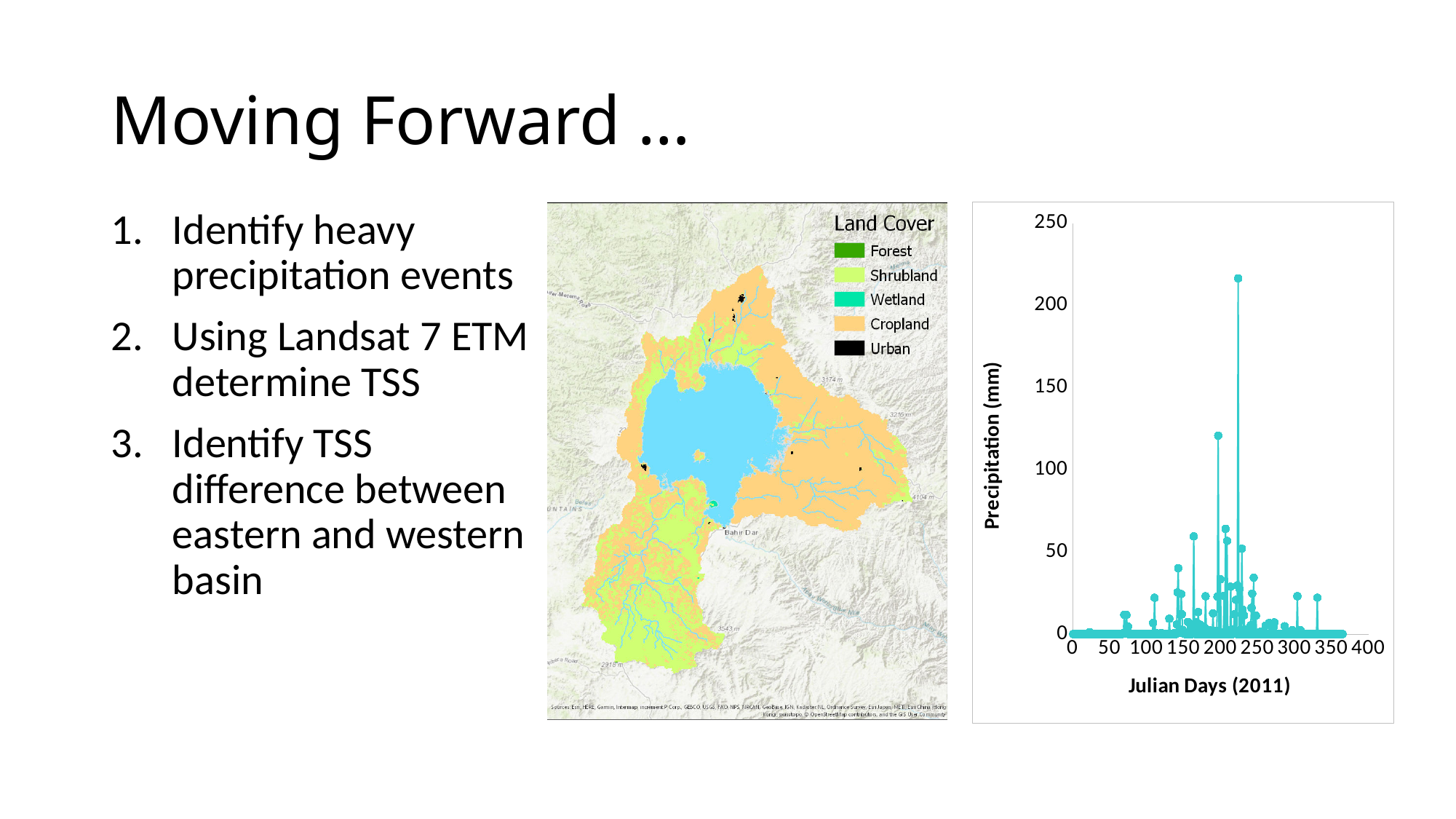
In the precipitation chart, is the tallest spike located before or after Julian day 200? after In the precipitation chart, is the second-highest spike greater or less than 100? greater What is the title of the x axis of the precipitation chart? Julian Days (2011) In the precipitation chart, is the highest precipitation value greater or less than 250? less In the precipitation chart, are the precipitation values before Julian day 50 greater or less than 50? less What kind of chart is shown on the right of the slide? line chart What is the title of the y axis of the precipitation chart? Precipitation (mm) What is the maximum value shown on the y axis of the precipitation chart? 250